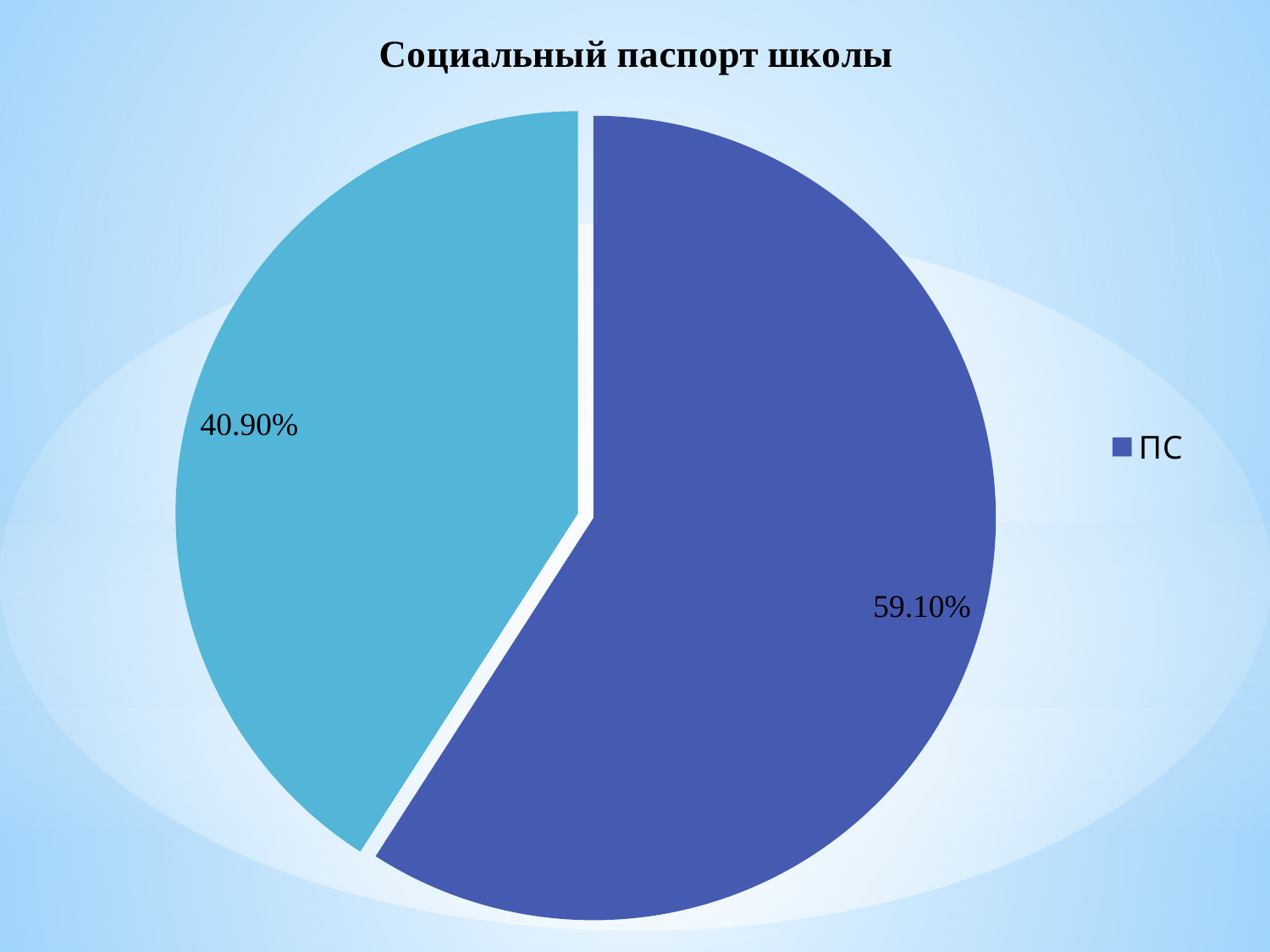
What is the title of the chart? Социальный паспорт школы What share of the pie does the ПС slice represent? 59.10% Which is larger: the ПС slice or the light blue slice? ПС What is the value of the smallest slice in the pie chart? 40.90% How many entries does the legend list? 1 Is the value of the ПС slice greater or less than 50%? greater What is the difference between the two slice values in the pie chart? 18.20% What value is printed on the light blue slice of the pie? 40.90% Which slice is the largest in the pie chart? ПС How many slices does the pie chart have? 2 What colour is the ПС slice in the pie chart? dark blue What kind of chart is shown on the slide? pie chart